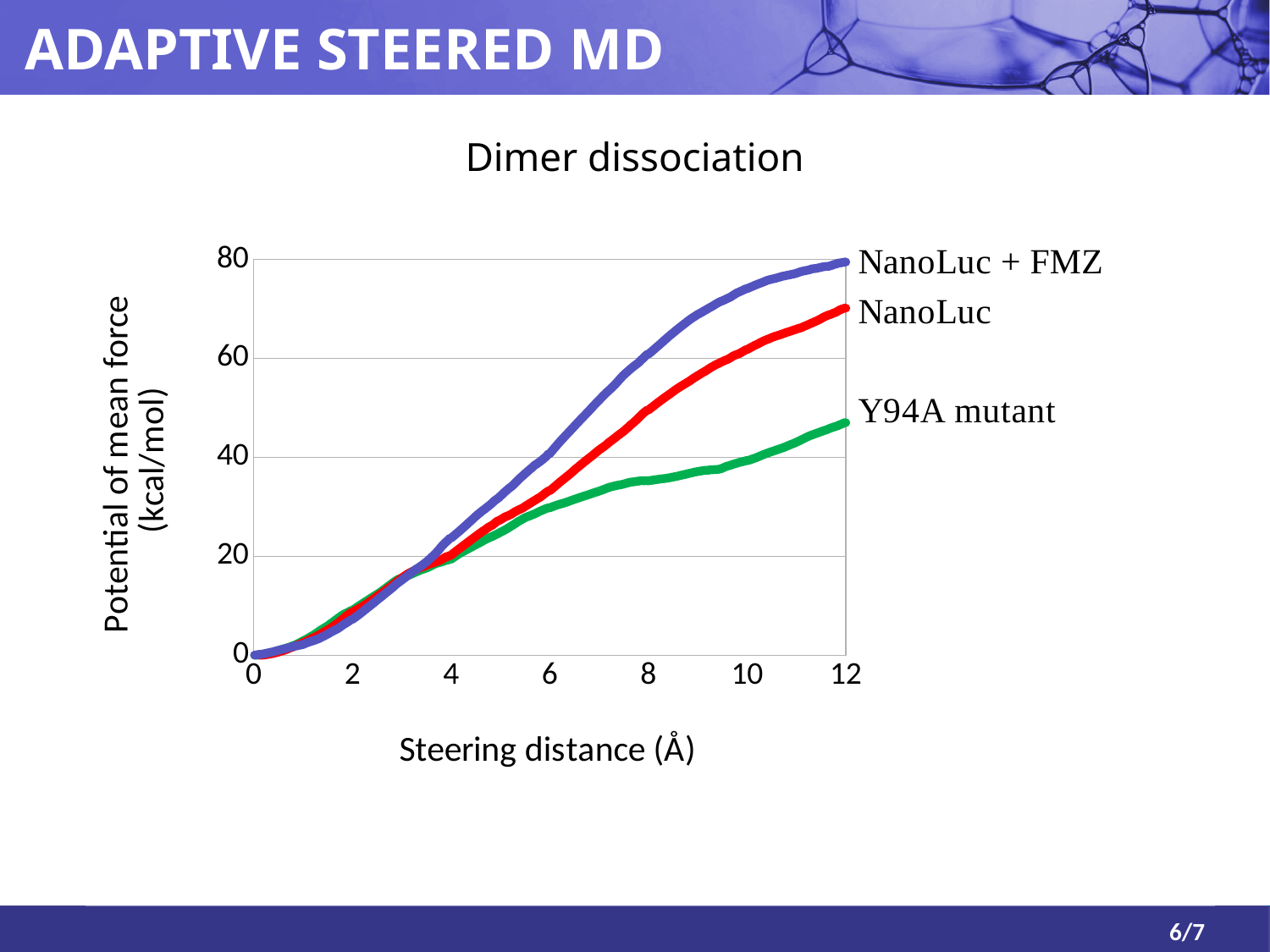
Does the potential of mean force for NanoLuc rise or fall as steering distance increases? rise At a steering distance of 8 Å, which is larger: the value for NanoLuc or the value for Y94A mutant? NanoLuc What kind of chart is shown on the slide? line chart Is the value for Y94A mutant at a steering distance of 8 Å greater or less than 40? less What is the title of the chart? Dimer dissociation Is the value for NanoLuc + FMZ at a steering distance of 10 Å greater or less than 60? greater What is the label of the x axis? Steering distance (Å) How many series are plotted in the Dimer dissociation chart? 3 Which series has the highest potential of mean force at a steering distance of 12 Å? NanoLuc + FMZ Is the value for NanoLuc + FMZ at a steering distance of 12 Å greater or less than 60? greater Which series has the lowest potential of mean force at a steering distance of 12 Å? Y94A mutant